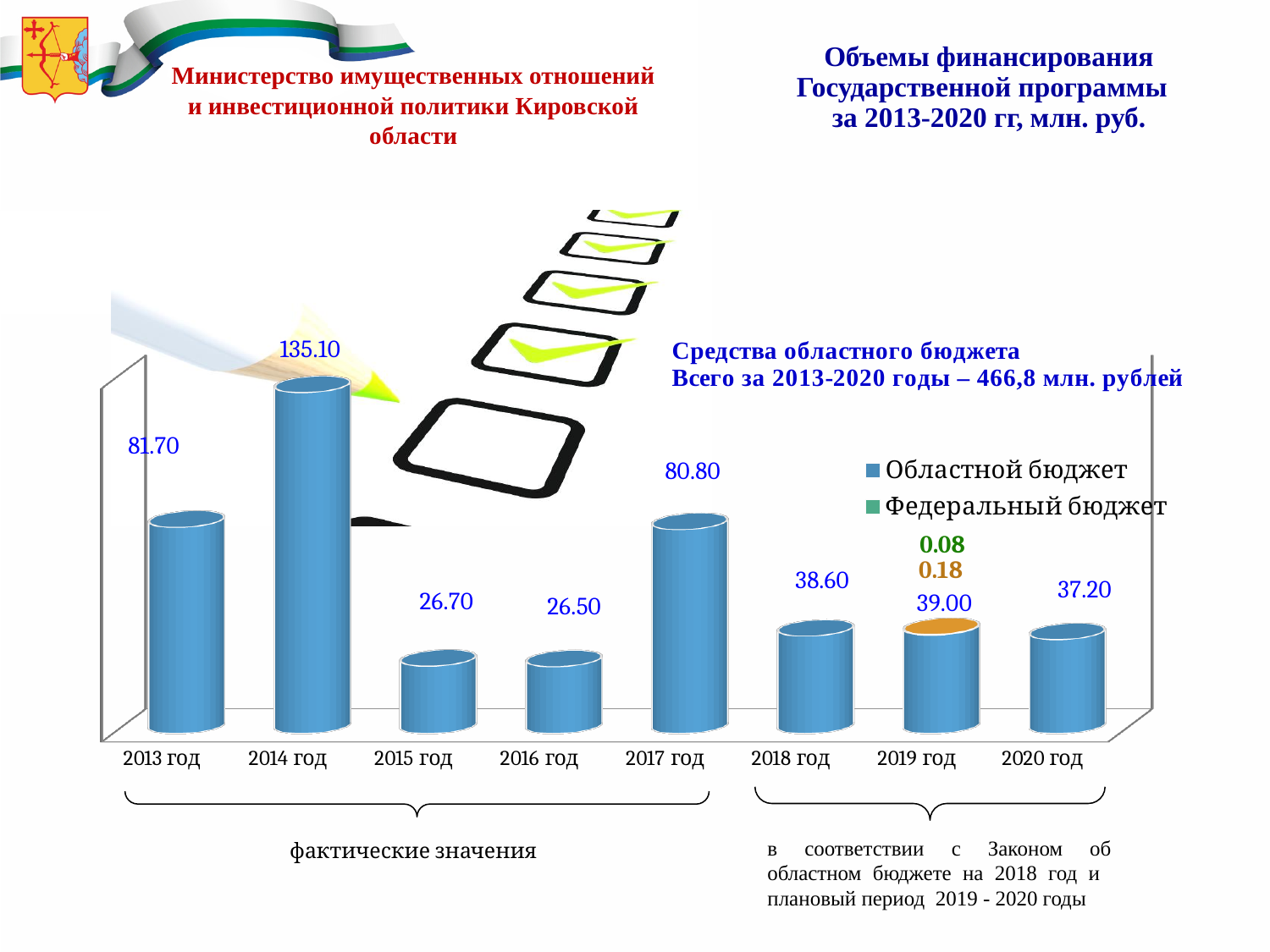
Which year has the highest value for Областной бюджет? 2014 год How many series does the legend list? 2 What kind of chart is shown on the slide? bar chart What is the difference between the values for 2018 год and 2020 год? 1.40 How many years are shown on the x axis of the chart? 8 Which is larger, the value for 2013 год or for 2017 год? 2013 год What is the value for 2020 год (Областной бюджет)? 37.20 What is the value for 2014 год (Областной бюджет)? 135.10 What is the difference between the values for 2014 год and 2013 год? 53.40 Do the values rise or fall from 2014 год to 2016 год? fall What is the value for 2013 год (Областной бюджет)? 81.70 Which year has the lowest value for Областной бюджет? 2016 год